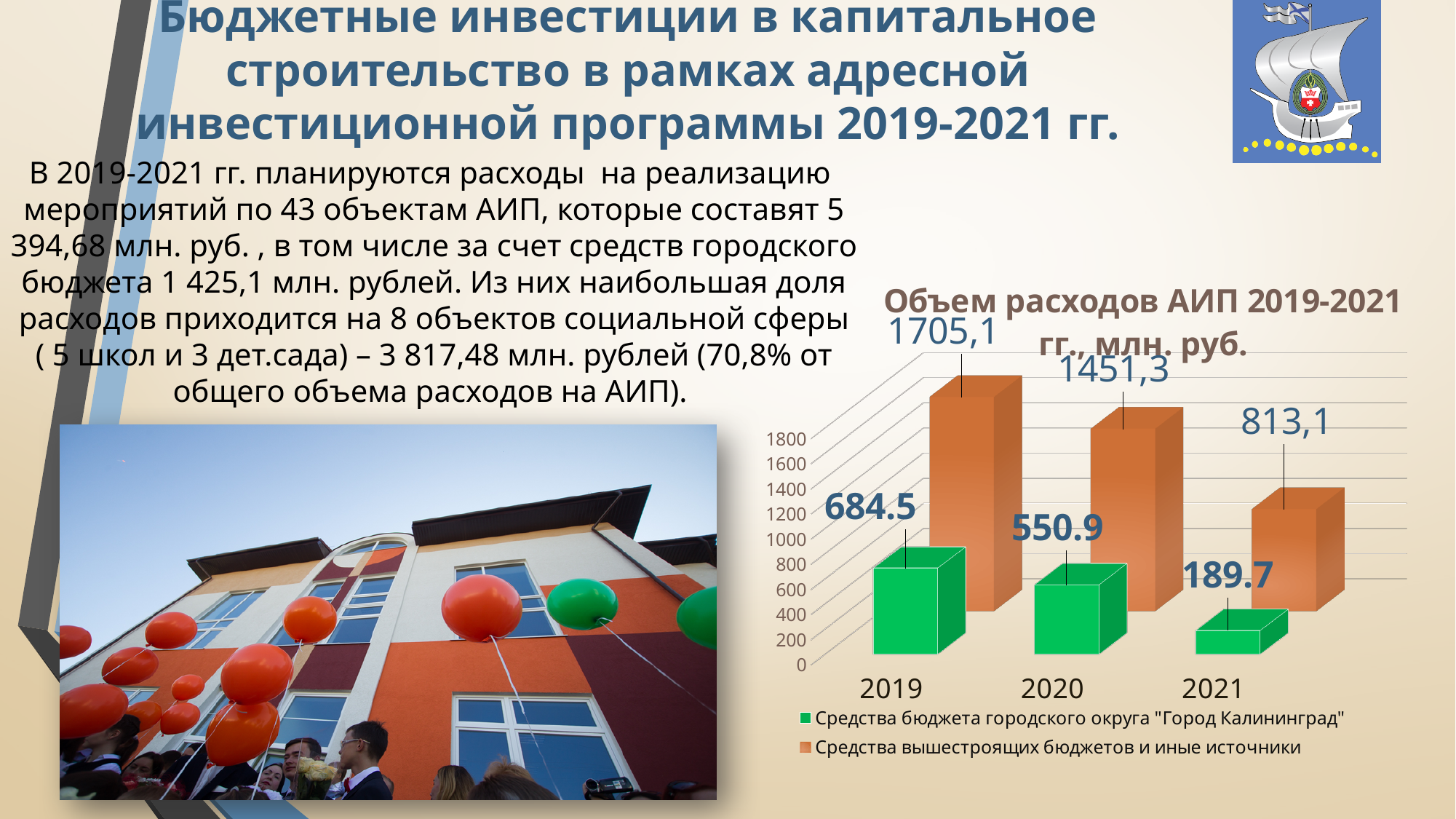
What is the value for 2019 in the series "Средства вышестроящих бюджетов и иные источники"? 1705,1 What is the difference between the 2020 and 2021 values for "Средства вышестроящих бюджетов и иные источники"? 638,2 How many years are shown on the x axis of the chart? 3 What is the difference between the 2019 and 2020 values for "Средства бюджета городского округа "Город Калининград""? 133.6 What is the value for 2020 in the series "Средства вышестроящих бюджетов и иные источники"? 1451,3 Which year has the highest value for "Средства бюджета городского округа "Город Калининград""? 2019 Which year has the lowest value for "Средства вышестроящих бюджетов и иные источники"? 2021 In 2021, which series has the larger value: "Средства бюджета городского округа "Город Калининград"" or "Средства вышестроящих бюджетов и иные источники"? Средства вышестроящих бюджетов и иные источники What is the value for 2021 in the series "Средства бюджета городского округа "Город Калининград""? 189.7 Do the values for "Средства вышестроящих бюджетов и иные источники" rise or fall from 2019 to 2021? Fall What kind of chart is shown on the slide? Bar chart How many series does the chart legend list? 2